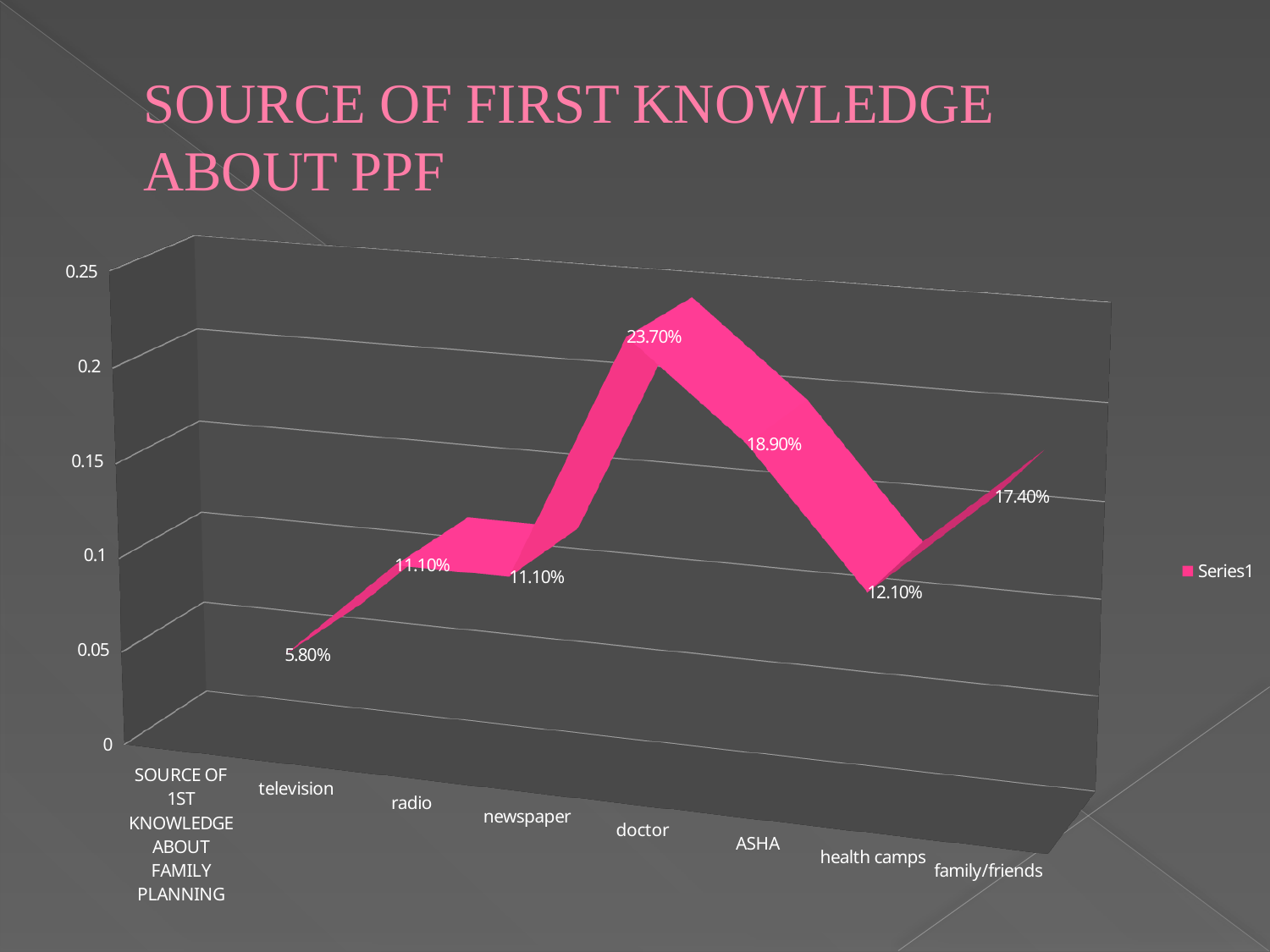
What is the difference between the values for doctor and ASHA? 4.80% Which source has the lowest value? television Which source has the highest value? doctor How many series does the legend list? 1 What is the value for family/friends? 17.40% What kind of chart is shown on the slide? line chart Which is larger, the value for ASHA or the value for family/friends? ASHA What is the value for television? 5.80% Is the value for doctor greater or less than 0.2 on the axis? greater Do the values rise or fall from doctor to health camps? fall What is the value for health camps? 12.10% What is the value for doctor? 23.70%